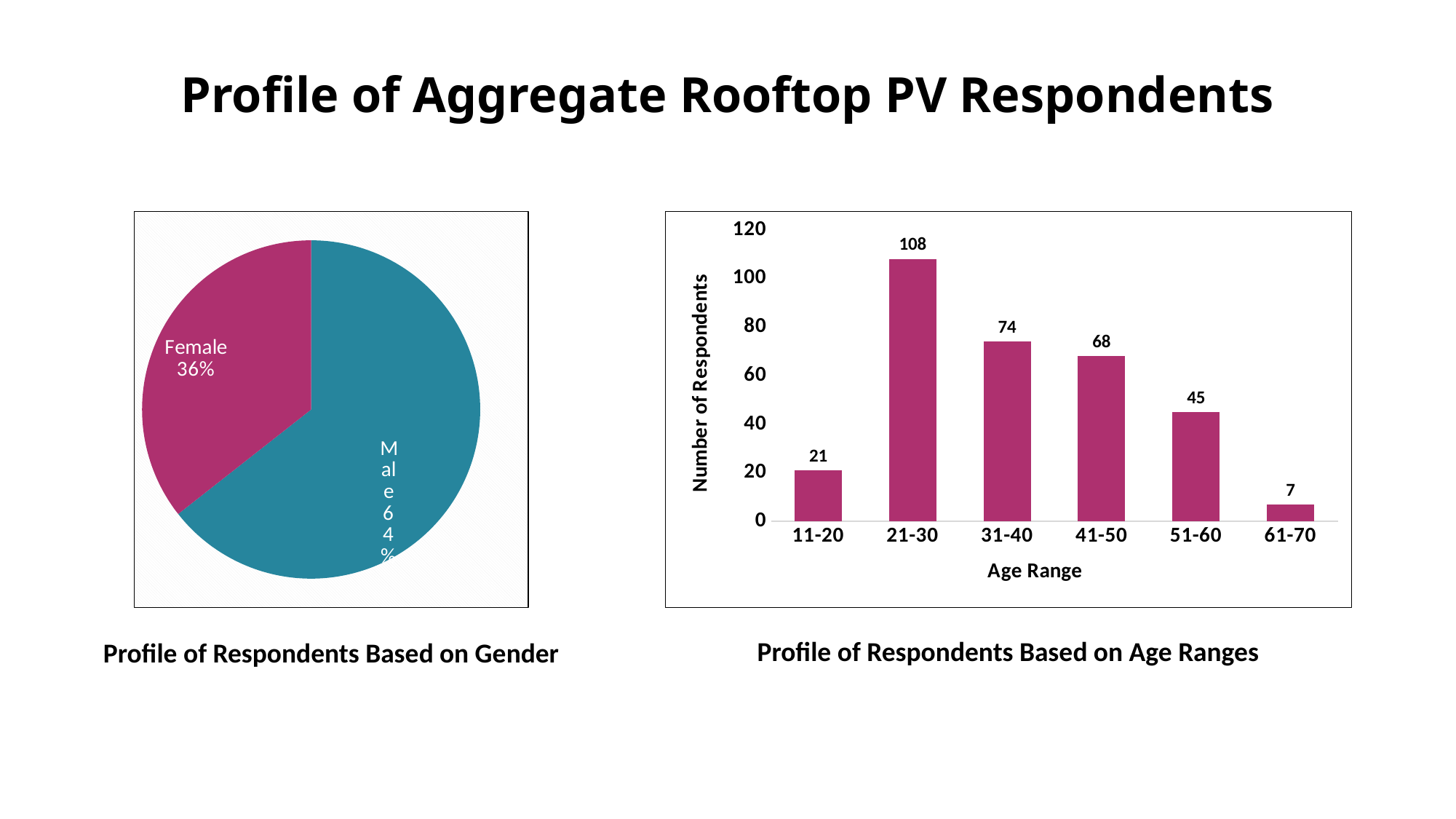
What kind of chart is 'Profile of Respondents Based on Gender'? Pie chart In the 'Profile of Respondents Based on Age Ranges' chart, how many respondents are in the 21-30 age range? 108 In the 'Profile of Respondents Based on Age Ranges' chart, which age range has the highest number of respondents? 21-30 What is the y-axis label of the 'Profile of Respondents Based on Age Ranges' chart? Number of Respondents In the 'Profile of Respondents Based on Age Ranges' chart, which age range has the lowest number of respondents? 61-70 In the 'Profile of Respondents Based on Age Ranges' chart, how many respondents are in the 61-70 age range? 7 In the 'Profile of Respondents Based on Age Ranges' chart, do the values rise or fall from the 21-30 age range to the 61-70 age range? Fall In the 'Profile of Respondents Based on Gender' chart, what share of respondents are Female? 36% In the 'Profile of Respondents Based on Age Ranges' chart, which has more respondents: 11-20 or 51-60? 51-60 What kind of chart is 'Profile of Respondents Based on Age Ranges'? Bar chart In the 'Profile of Respondents Based on Age Ranges' chart, what is the difference in respondents between the 31-40 and 41-50 age ranges? 6 In the 'Profile of Respondents Based on Age Ranges' chart, how many age ranges are shown? 6